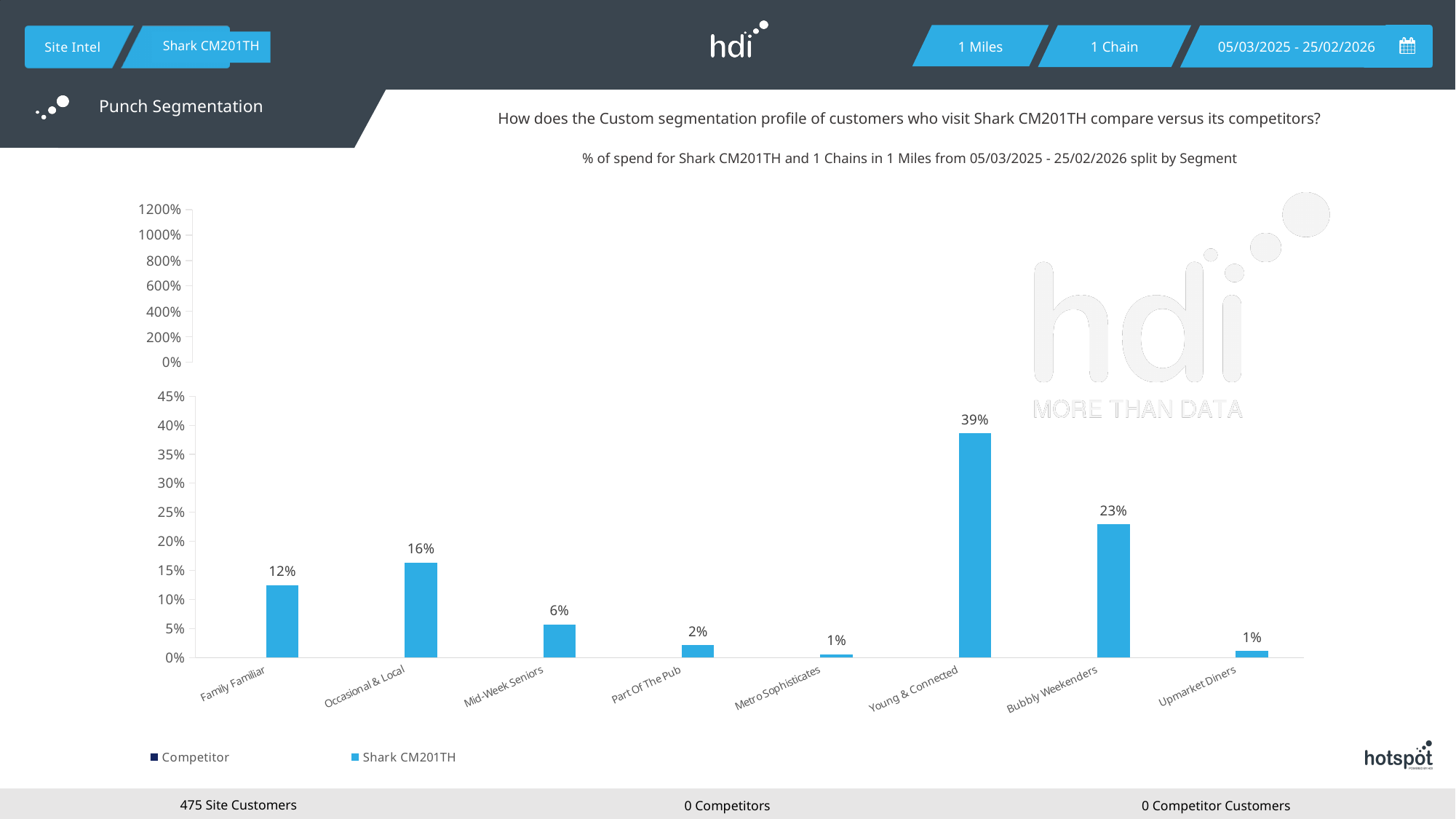
In the lower chart, which is larger, the value for Family Familiar or the value for Mid-Week Seniors? Family Familiar In the lower chart, what is the value for Young & Connected? 39% In the lower chart, which segment has the highest value? Young & Connected In the lower chart, what is the value for Bubbly Weekenders? 23% In the lower chart, what is the value for Occasional & Local? 16% How many segments are shown on the x axis of the lower chart? 8 How many series does the legend list? 2 What is the difference between the values for Family Familiar and Mid-Week Seniors in the lower chart? 6% In the lower chart, is the value for Occasional & Local greater or less than 15%? greater In the lower chart, what is the value for Part Of The Pub? 2% What kind of chart is the lower chart? bar chart In the lower chart, what is the difference between the values for Young & Connected and Bubbly Weekenders? 16%